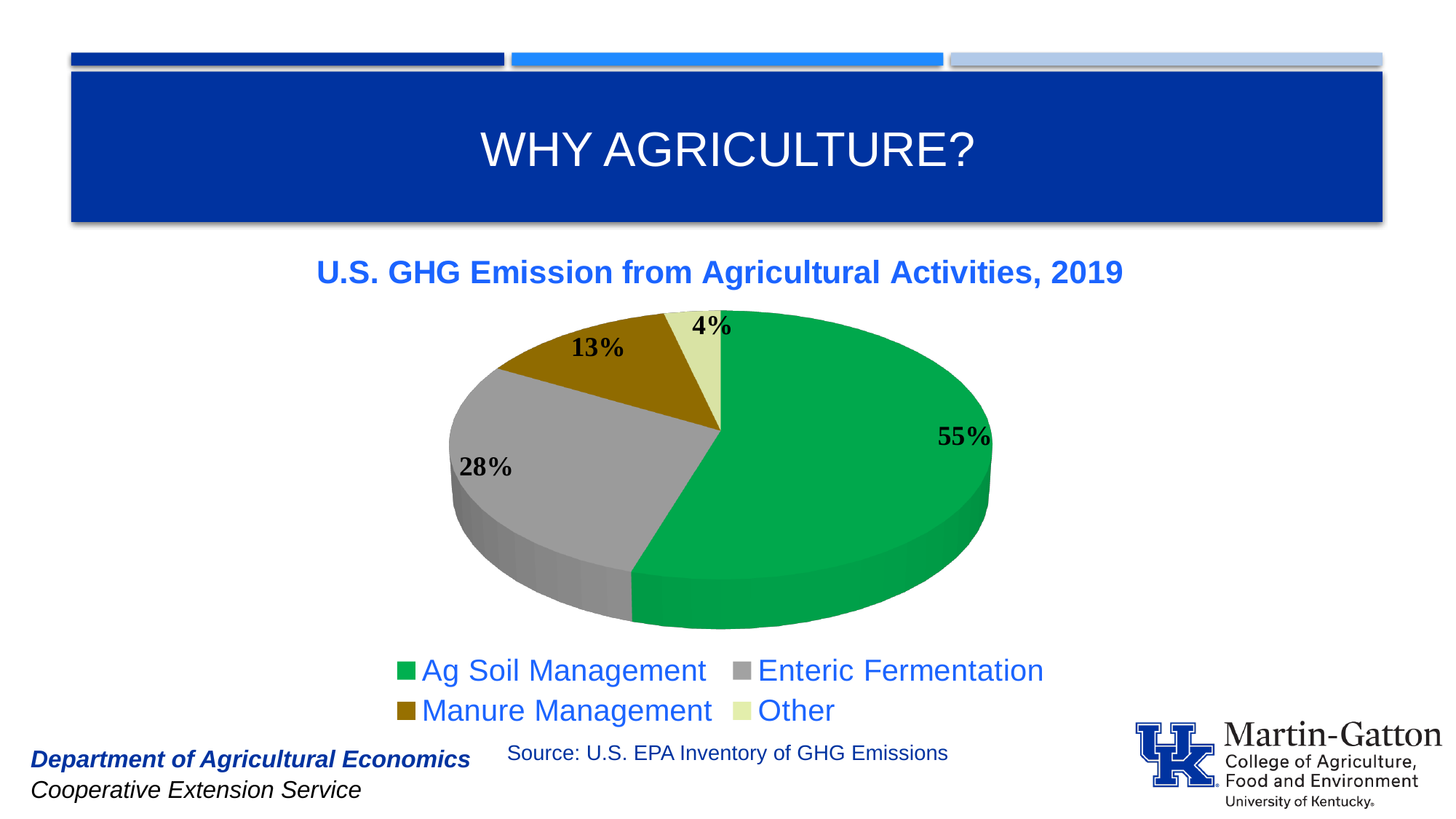
Which category has the largest share of the pie? Ag Soil Management What kind of chart is shown on the slide? Pie chart Which category has the smallest share of the pie? Other How many percentage points larger is Ag Soil Management than Enteric Fermentation? 27 Which is larger, Enteric Fermentation or Manure Management? Enteric Fermentation What percentage is shown for the Other category? 4% How many categories does the pie chart show? 4 What percentage is shown for Manure Management? 13% What share of the pie is Enteric Fermentation? 28% What share of U.S. GHG emissions from agricultural activities in 2019 comes from Ag Soil Management? 55% What is the difference in percentage points between Manure Management and Other? 9 What is the title of the chart? U.S. GHG Emission from Agricultural Activities, 2019